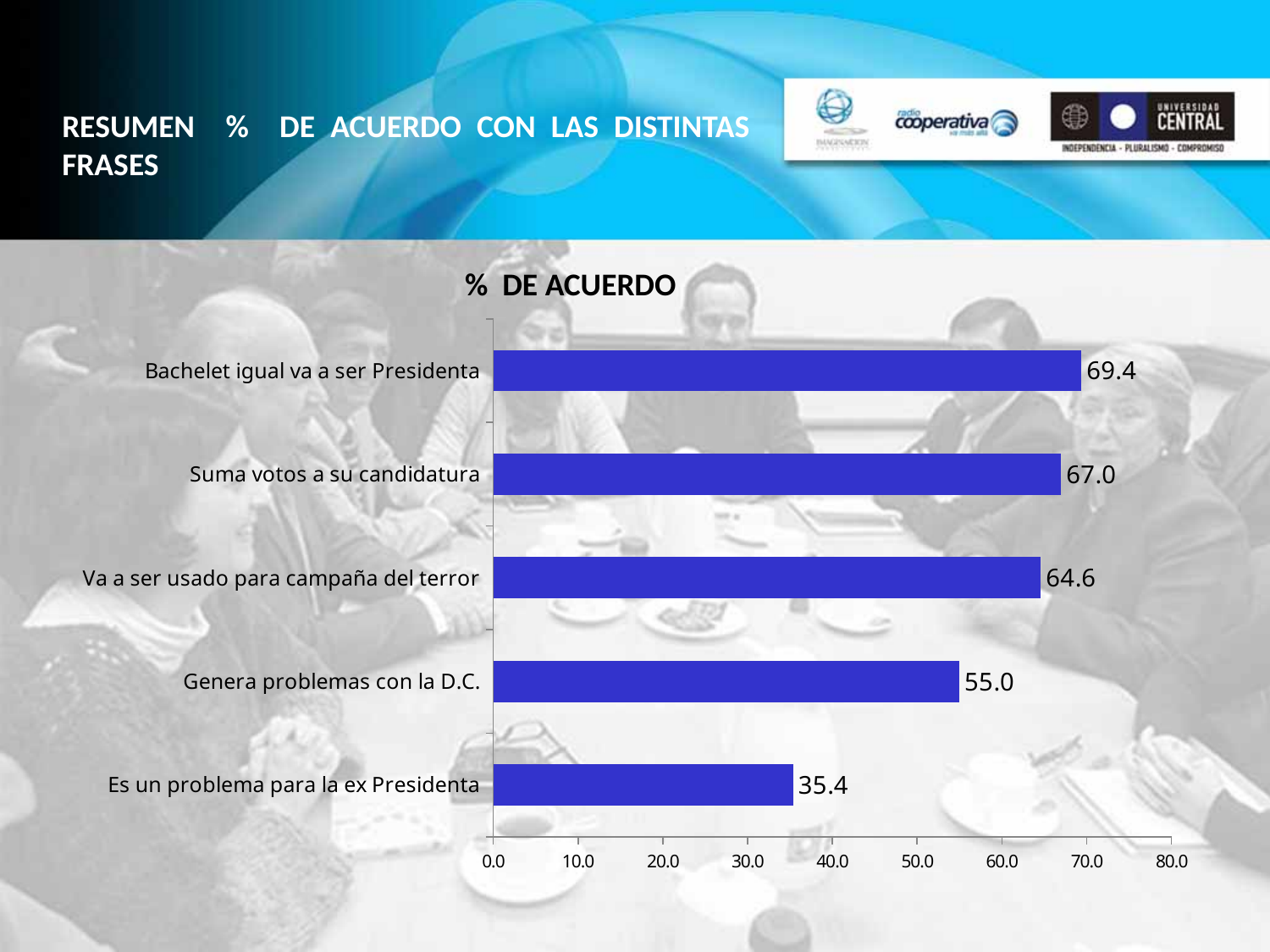
What is the title of the chart? % DE ACUERDO What is the value for "Bachelet igual va a ser Presidenta"? 69.4 What is the value for "Es un problema para la ex Presidenta"? 35.4 What is the difference between the values for "Bachelet igual va a ser Presidenta" and "Es un problema para la ex Presidenta"? 34.0 How many categories are shown in the chart? 5 Is the value for "Va a ser usado para campaña del terror" greater or less than 60.0? greater What kind of chart is shown on the slide? Bar chart Which is larger, the value for "Genera problemas con la D.C." or the value for "Es un problema para la ex Presidenta"? Genera problemas con la D.C. Which category has the highest value? Bachelet igual va a ser Presidenta What is the difference between the values for "Suma votos a su candidatura" and "Va a ser usado para campaña del terror"? 2.4 What is the value for "Genera problemas con la D.C."? 55.0 Which category has the lowest value? Es un problema para la ex Presidenta